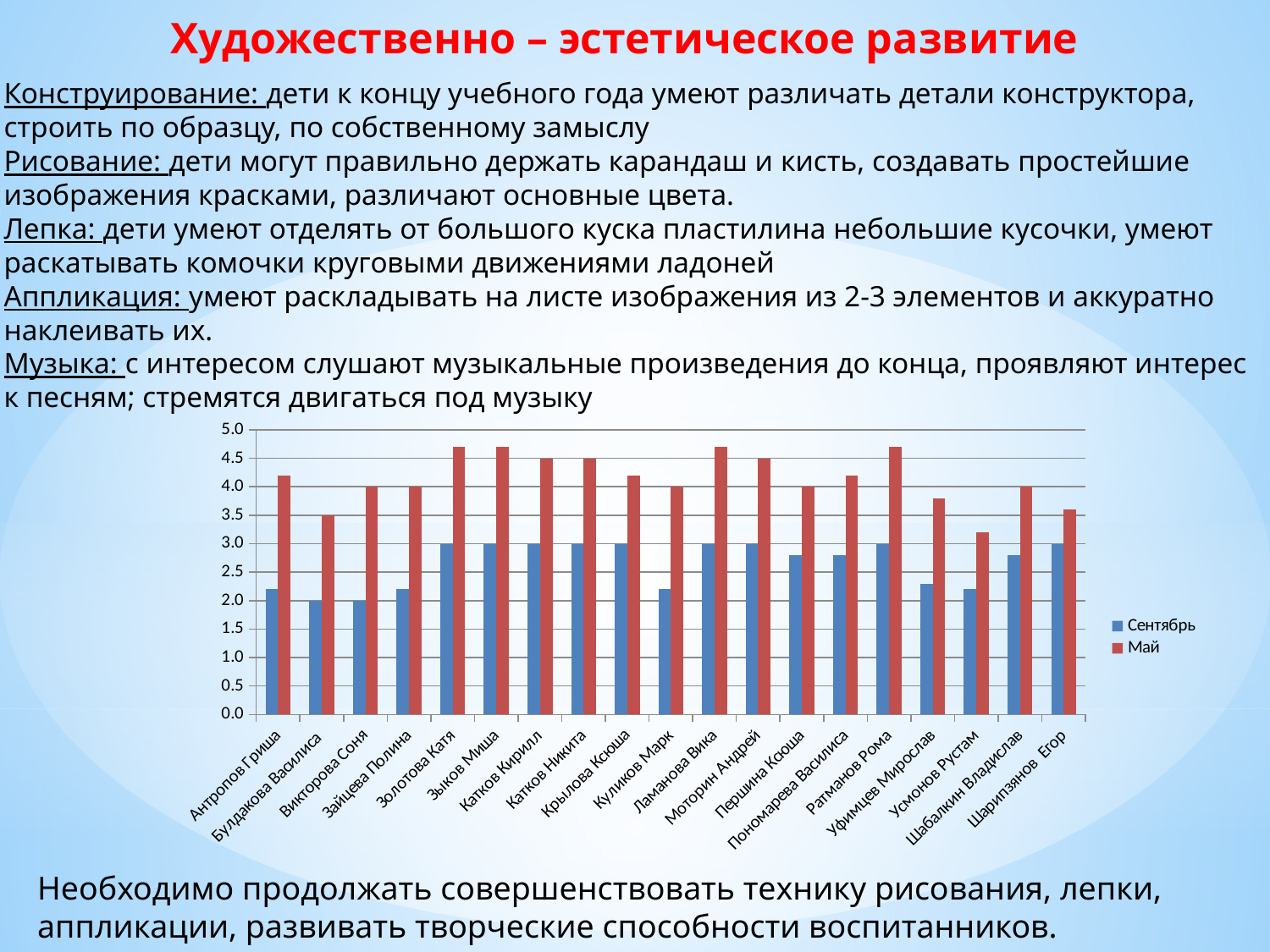
Is the Май value for Усмонов Рустам greater or less than 3.5? less For Викторова Соня, what is the difference between the Май and Сентябрь values? 2.0 What is the Май value for Катков Кирилл? 4.5 What is the Май value for Викторова Соня? 4.0 Is the Сентябрь value for Антропов Гриша greater or less than 2.5? less What is the Май value for Булдакова Василиса? 3.5 What kind of chart is shown on the slide? bar chart How many series does the legend list? 2 How many children (categories) are shown on the x axis of the chart? 19 What is the Сентябрь value for Золотова Катя? 3.0 Which child has the lowest Май value? Усмонов Рустам Which is larger for Антропов Гриша: the Сентябрь value or the Май value? Май